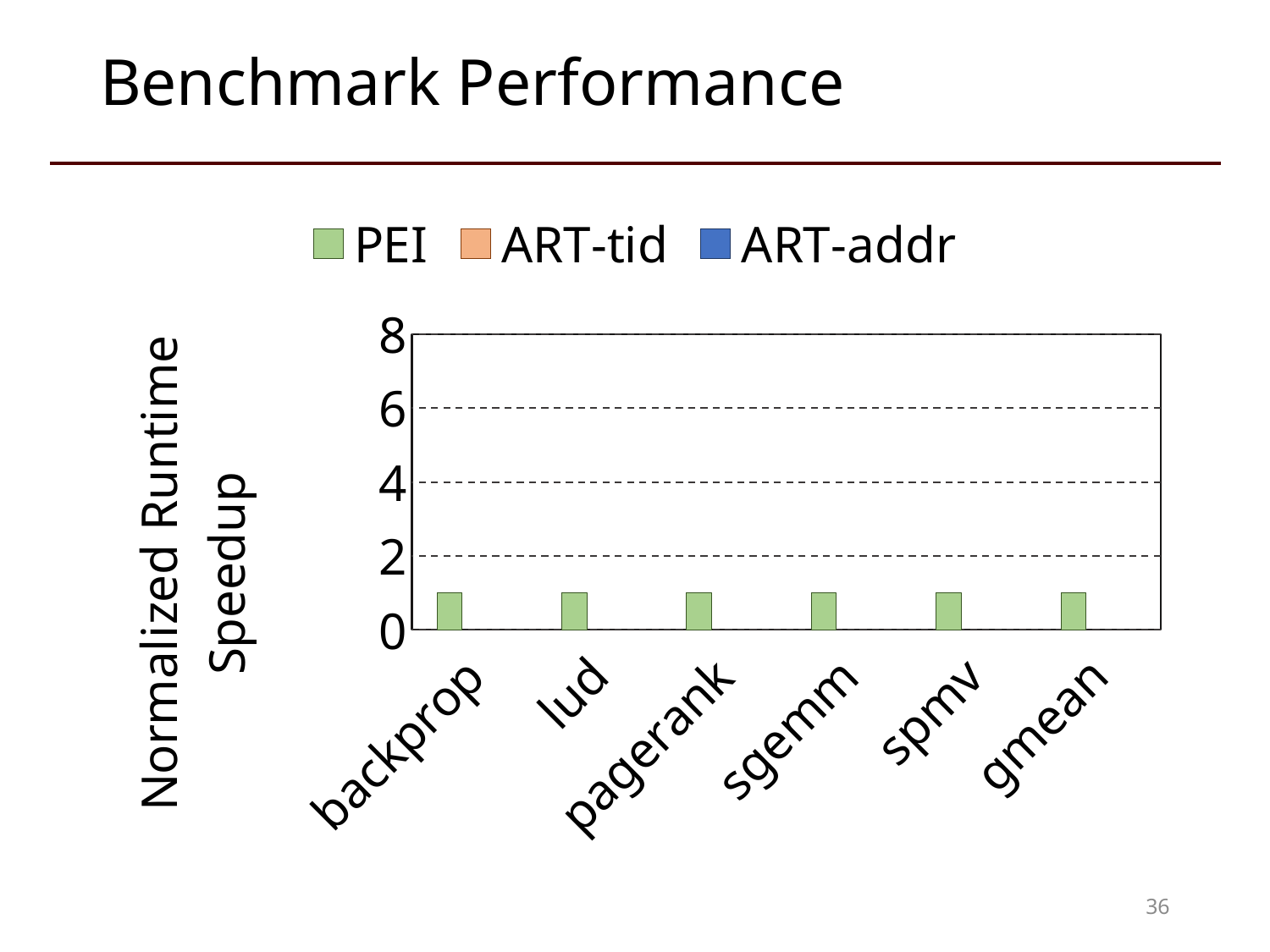
How many series does the legend list? 3 Is the PEI value for spmv greater or less than 2? less How many benchmark categories are shown on the x axis? 6 What kind of chart is shown on the slide? bar chart Is the PEI value for pagerank greater or less than 4? less Is the PEI value for lud greater or less than 2? less What is the highest value shown on the y axis? 8 What is the title of the slide containing the chart? Benchmark Performance What is the label on the y axis of the chart? Normalized Runtime Speedup